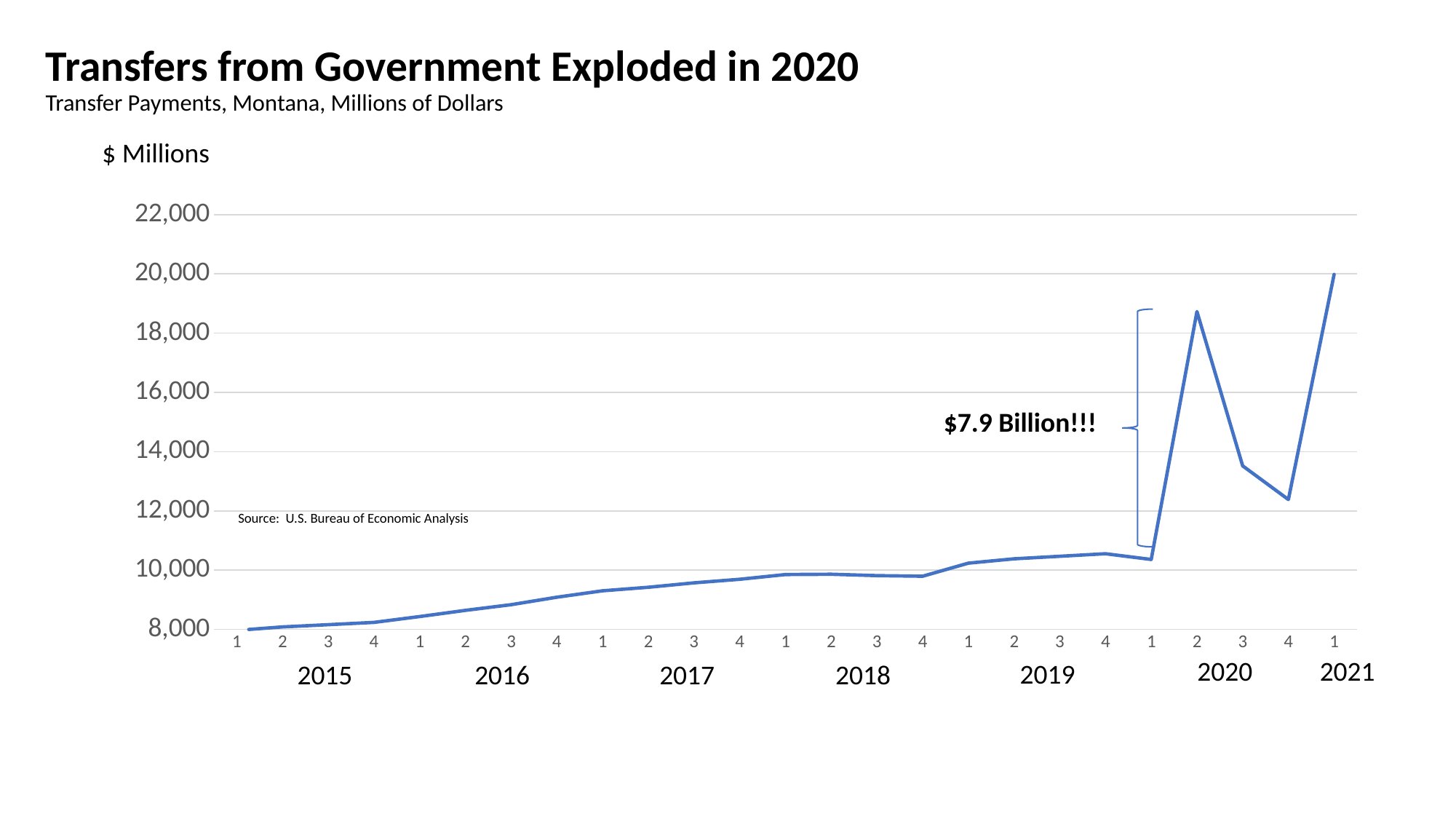
What kind of chart is shown on the slide? line chart Is the value for 2020 Q2 greater or less than 18,000? greater Is the value for 2019 Q4 greater or less than 12,000? less Is the value for 2020 Q4 greater or less than 14,000? less Which is larger, the value for 2020 Q2 or the value for 2020 Q3? 2020 Q2 Do transfer payments generally rise or fall from 2015 Q1 through 2019 Q4? rise Which quarter has the highest transfer payments value on the chart? 2021 Q1 Which quarter has the lowest transfer payments value on the chart? 2015 Q1 How many quarterly data points are plotted on the chart? 25 What amount does the annotation next to the bracket on the chart state? $7.9 Billion!!! What is the title of the chart? Transfers from Government Exploded in 2020